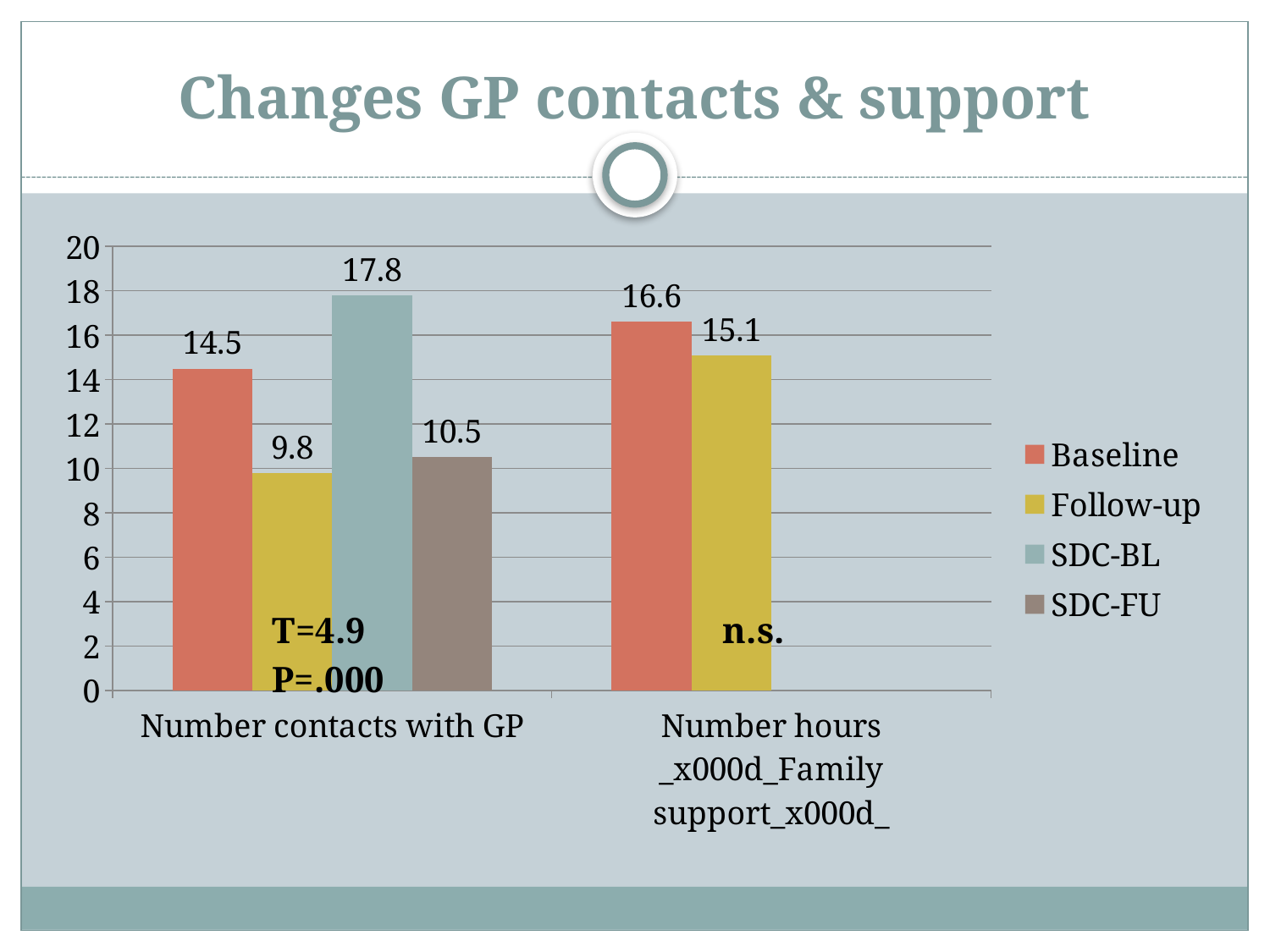
What is the Baseline value for Number contacts with GP? 14.5 What is the Follow-up value for Number hours Family support? 15.1 What is the Follow-up value for Number contacts with GP? 9.8 Which series has the highest value for Number contacts with GP? SDC-BL How many series does the legend list? 4 What kind of chart is shown on the slide? Bar chart What is the Baseline value for Number hours Family support? 16.6 What is the difference between the Baseline and Follow-up values for Number contacts with GP? 4.7 Which series has the lowest value for Number contacts with GP? Follow-up Which is larger for Number hours Family support: Baseline or Follow-up? Baseline What is the SDC-BL value for Number contacts with GP? 17.8 What is the SDC-FU value for Number contacts with GP? 10.5